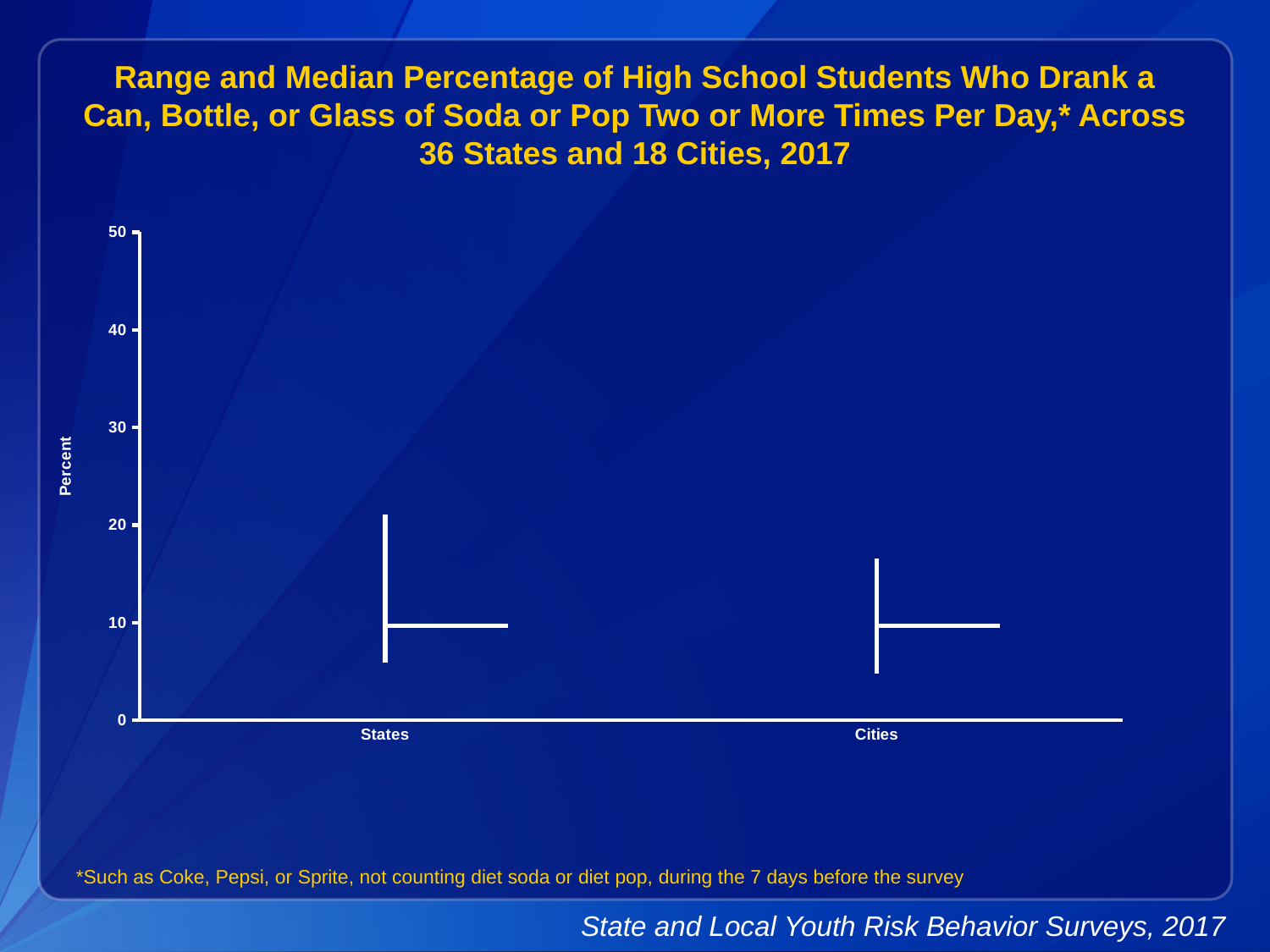
Is the top of the range for States greater or less than 15? greater Is the median for States greater or less than 20? less Is the bottom of the range for States greater or less than 10? less What is the highest value shown on the y axis? 50 What are the two categories shown on the x axis? States and Cities How many categories are shown on the x axis of the chart? 2 What is the label of the y axis? Percent Which category has the higher top of its range, States or Cities? States